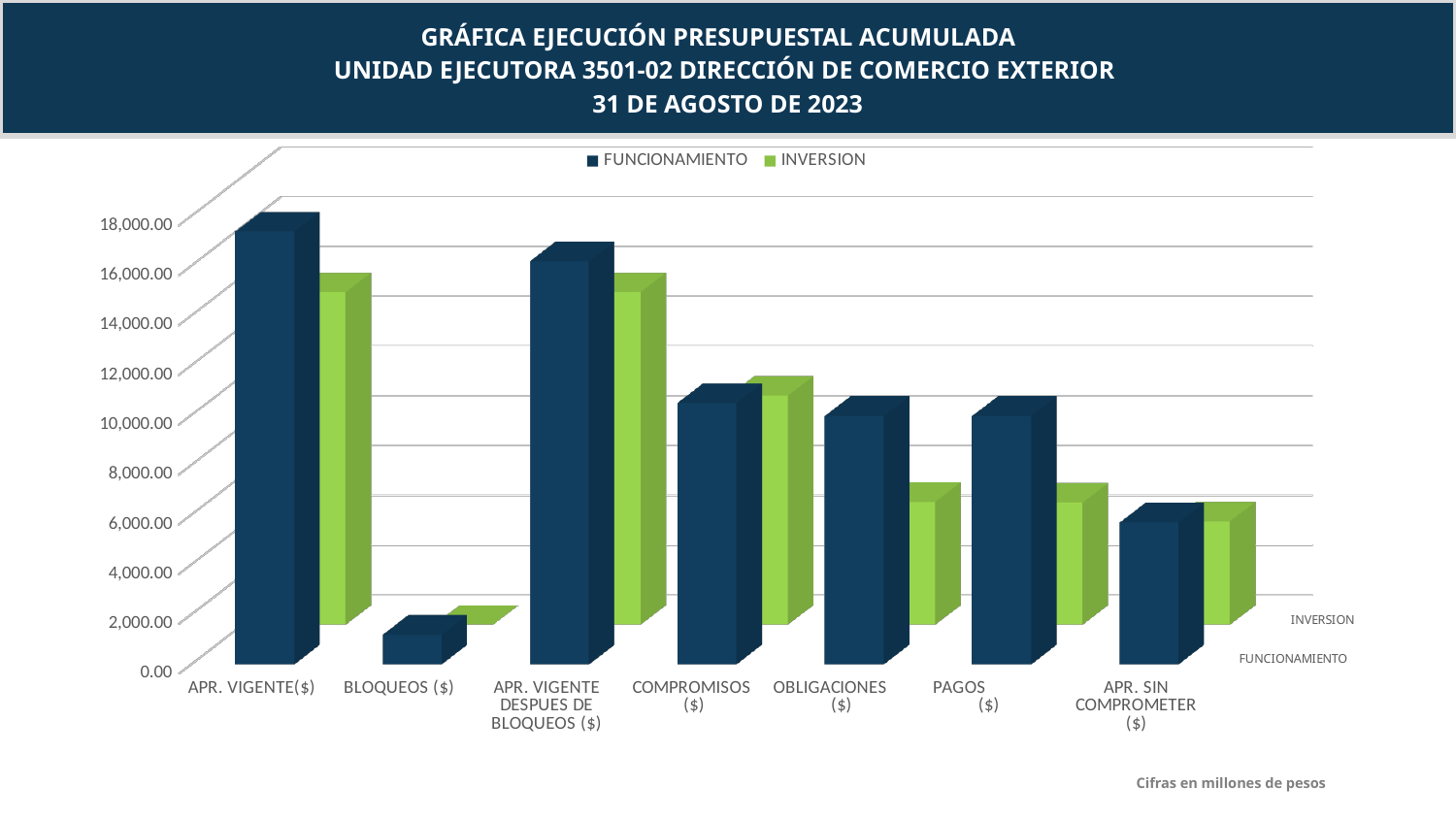
Which category has the lowest INVERSION value? BLOQUEOS ($) For APR. VIGENTE($), which series has the larger value, FUNCIONAMIENTO or INVERSION? FUNCIONAMIENTO What colour represents the INVERSION series in the chart? Green Is the FUNCIONAMIENTO value for APR. VIGENTE($) greater or less than 16,000.00? greater Which category has the highest FUNCIONAMIENTO value? APR. VIGENTE($) Is the INVERSION value for OBLIGACIONES ($) greater or less than 8,000.00? less How many series does the legend list? 2 Is the FUNCIONAMIENTO value for BLOQUEOS ($) greater or less than 2,000.00? less What kind of chart is shown on the slide? Bar chart Which category has the lowest FUNCIONAMIENTO value? BLOQUEOS ($) How many categories are shown on the x axis? 7 For OBLIGACIONES ($), which series has the larger value, FUNCIONAMIENTO or INVERSION? FUNCIONAMIENTO